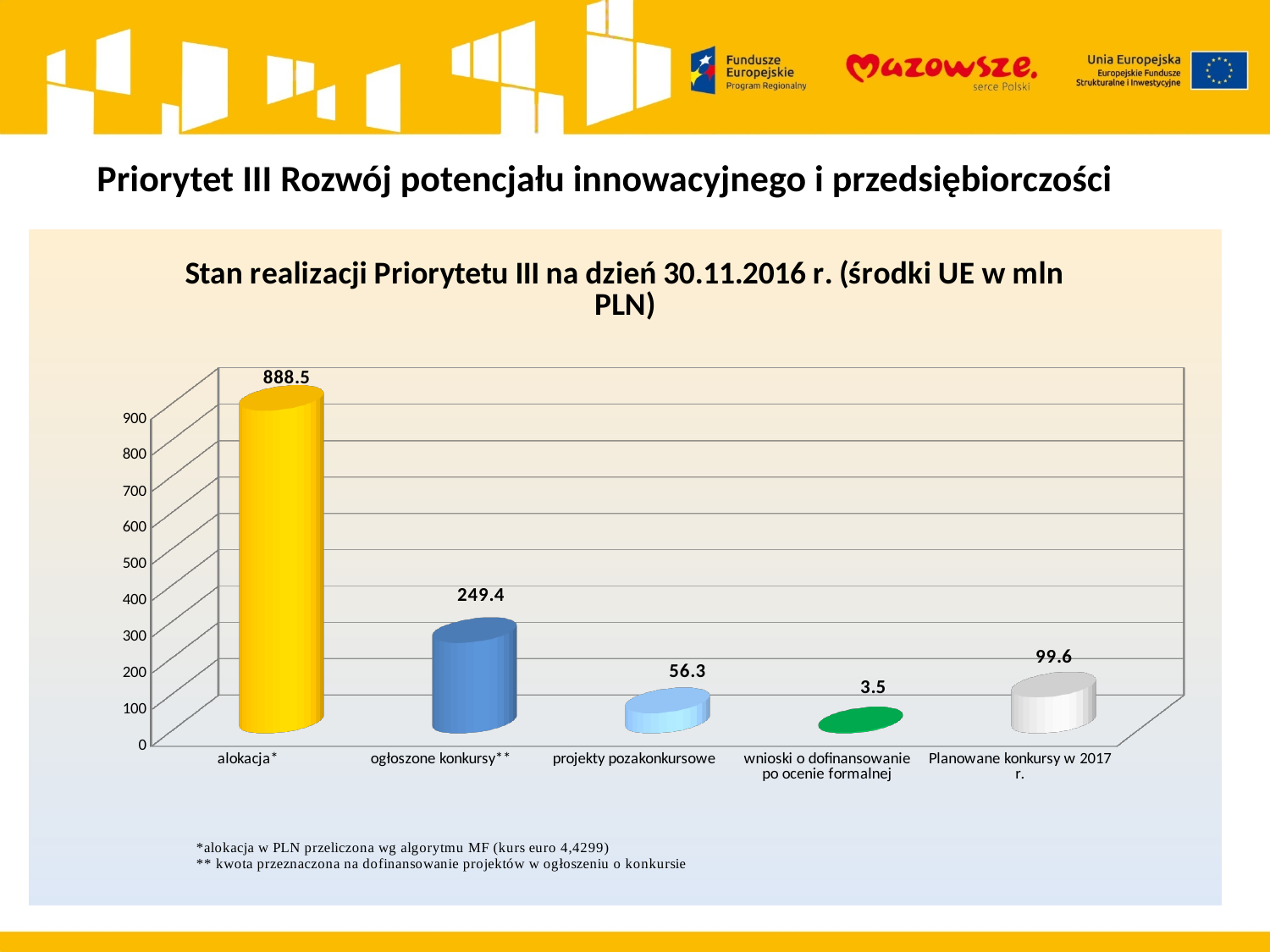
What is the value for wnioski o dofinansowanie po ocenie formalnej? 3.5 What is the title of the chart? Stan realizacji Priorytetu III na dzień 30.11.2016 r. (środki UE w mln PLN) What is the value for Planowane konkursy w 2017 r.? 99.6 What is the difference between the values for alokacja* and ogłoszone konkursy**? 639.1 What is the value for alokacja*? 888.5 Which is larger, the value for projekty pozakonkursowe or the value for Planowane konkursy w 2017 r.? Planowane konkursy w 2017 r. What is the value for projekty pozakonkursowe? 56.3 Which category has the lowest value? wnioski o dofinansowanie po ocenie formalnej What kind of chart is shown on the slide? bar chart What is the value for ogłoszone konkursy**? 249.4 Which category has the highest value? alokacja* How many categories are shown on the chart? 5